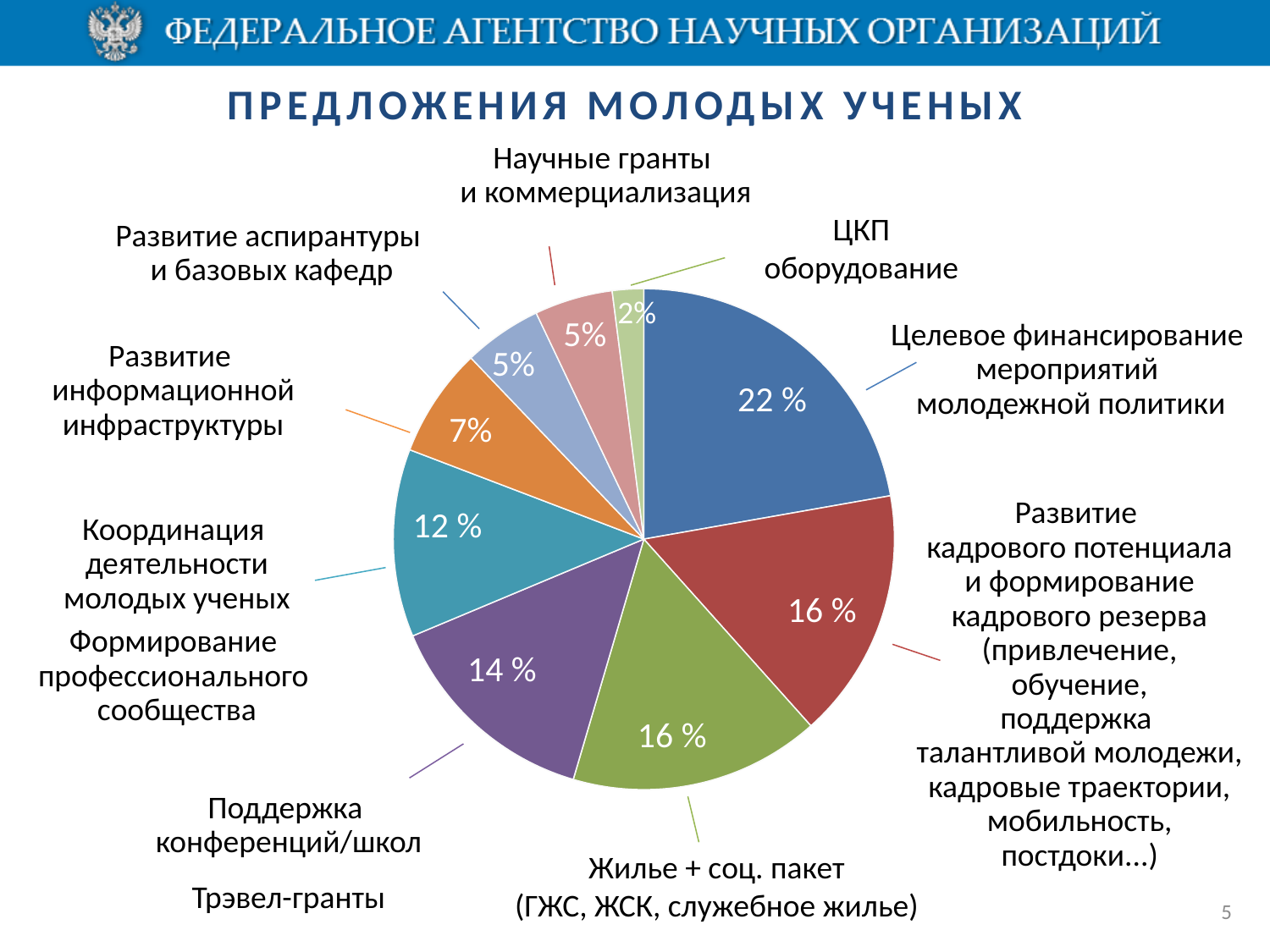
Which slice of the pie chart is the largest? Целевое финансирование мероприятий молодежной политики What is the difference in percentage points between 'Целевое финансирование мероприятий молодежной политики' and 'Поддержка конференций/школ'? 8 What share does the slice 'ЦКП оборудование' have? 2% What kind of chart is shown on the slide? pie chart Which slice of the pie chart is the smallest? ЦКП оборудование What share does the slice 'Целевое финансирование мероприятий молодежной политики' have? 22 % Which is larger: the slice for 'Развитие информационной инфраструктуры' or the slice for 'Развитие аспирантуры и базовых кафедр'? Развитие информационной инфраструктуры What share does the slice 'Координация деятельности молодых ученых' have? 12 % How many slices does the pie chart have? 9 What share does the slice 'Жилье + соц. пакет (ГЖС, ЖСК, служебное жилье)' have? 16 % What is the title of the slide's chart? ПРЕДЛОЖЕНИЯ МОЛОДЫХ УЧЕНЫХ What share does the slice 'Развитие информационной инфраструктуры' have? 7%